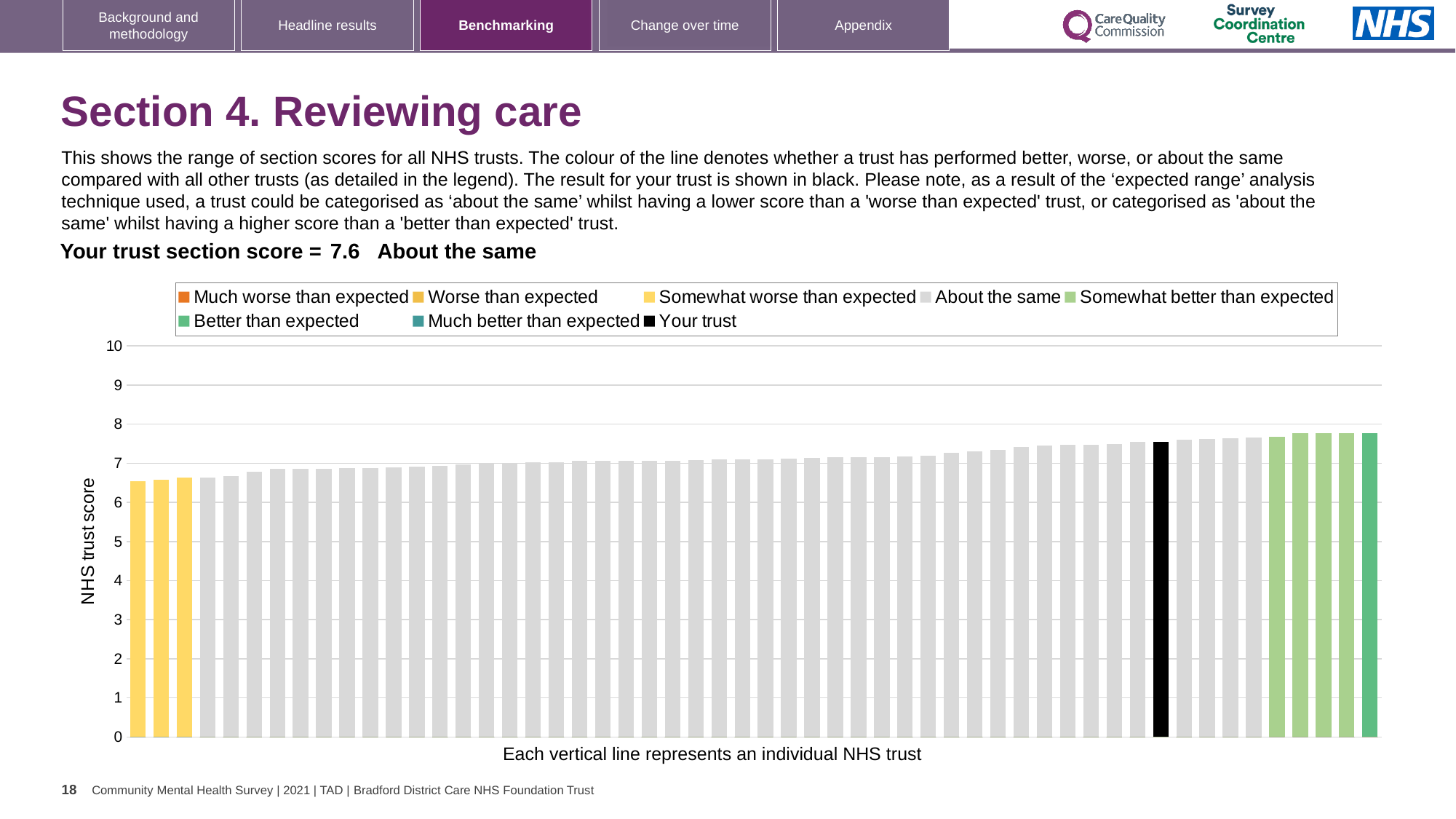
What kind of chart is shown on the slide? bar chart Which is larger, the leftmost bar or the rightmost bar? the rightmost bar What colour is the bar representing your trust? black Is the value for the tallest bar greater or less than 8? less How many entries does the chart legend list? 8 What is the section score for your trust? 7.6 Which benchmarking category is your trust placed in for this section? About the same Is the value for the leftmost bar greater or less than 7? less What is the label on the y axis of the chart? NHS trust score Is the value for your trust greater or less than 7? greater Do the bar values rise or fall from left to right along the x axis? rise